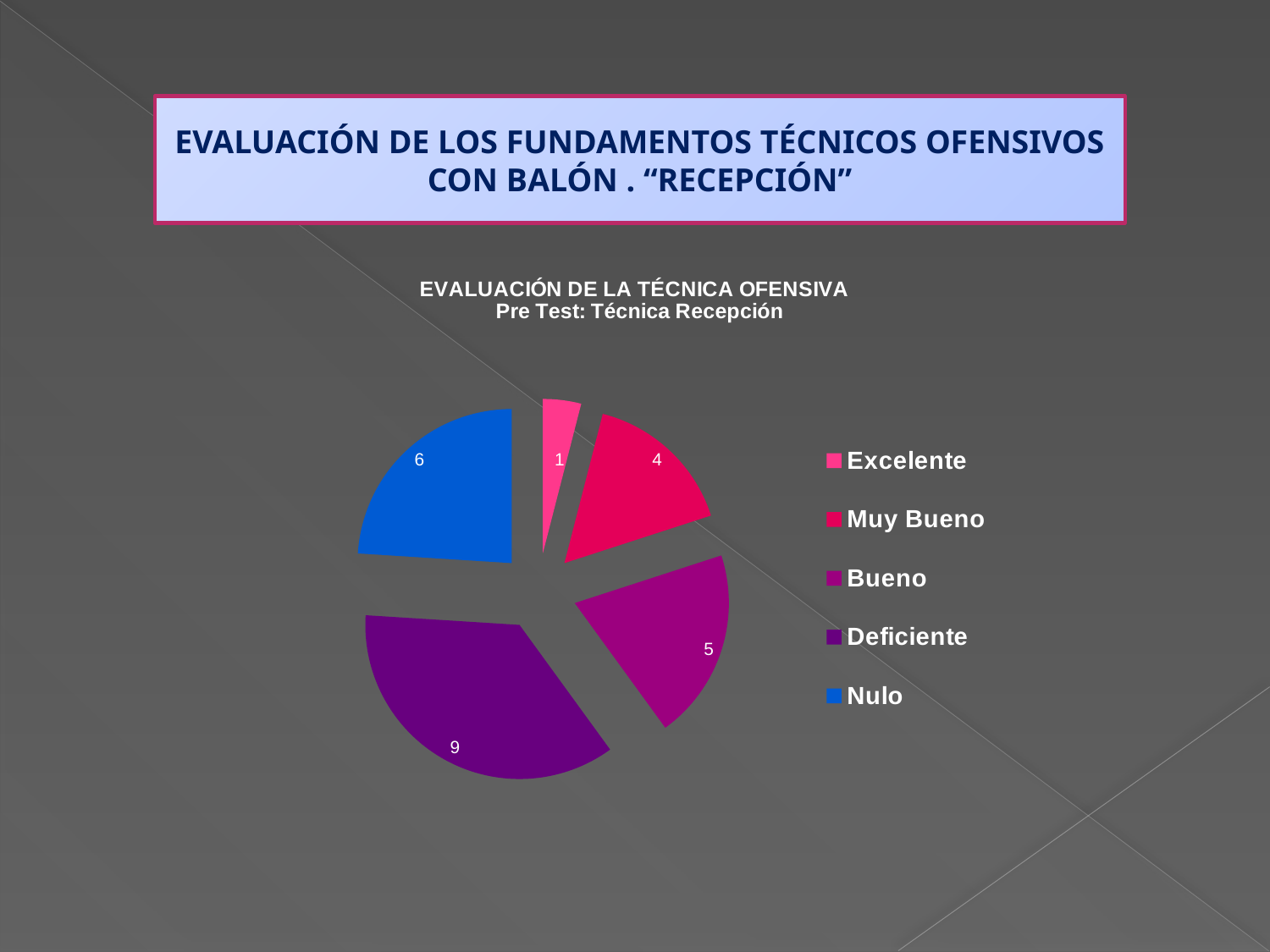
Which category has the smallest slice? Excelente What is the value for Nulo? 6 What is the value for Muy Bueno? 4 What is the value for Deficiente? 9 What is the value for Excelente? 1 Which is larger, the value for Nulo or the value for Muy Bueno? Nulo What type of chart is shown on the slide? pie chart Which category has the largest slice? Deficiente What share of the pie does the Deficiente slice represent? 36% What is the difference between the values for Deficiente and Bueno? 4 What is the subtitle of the chart below its main title? Pre Test: Técnica Recepción How many categories does the pie chart have? 5